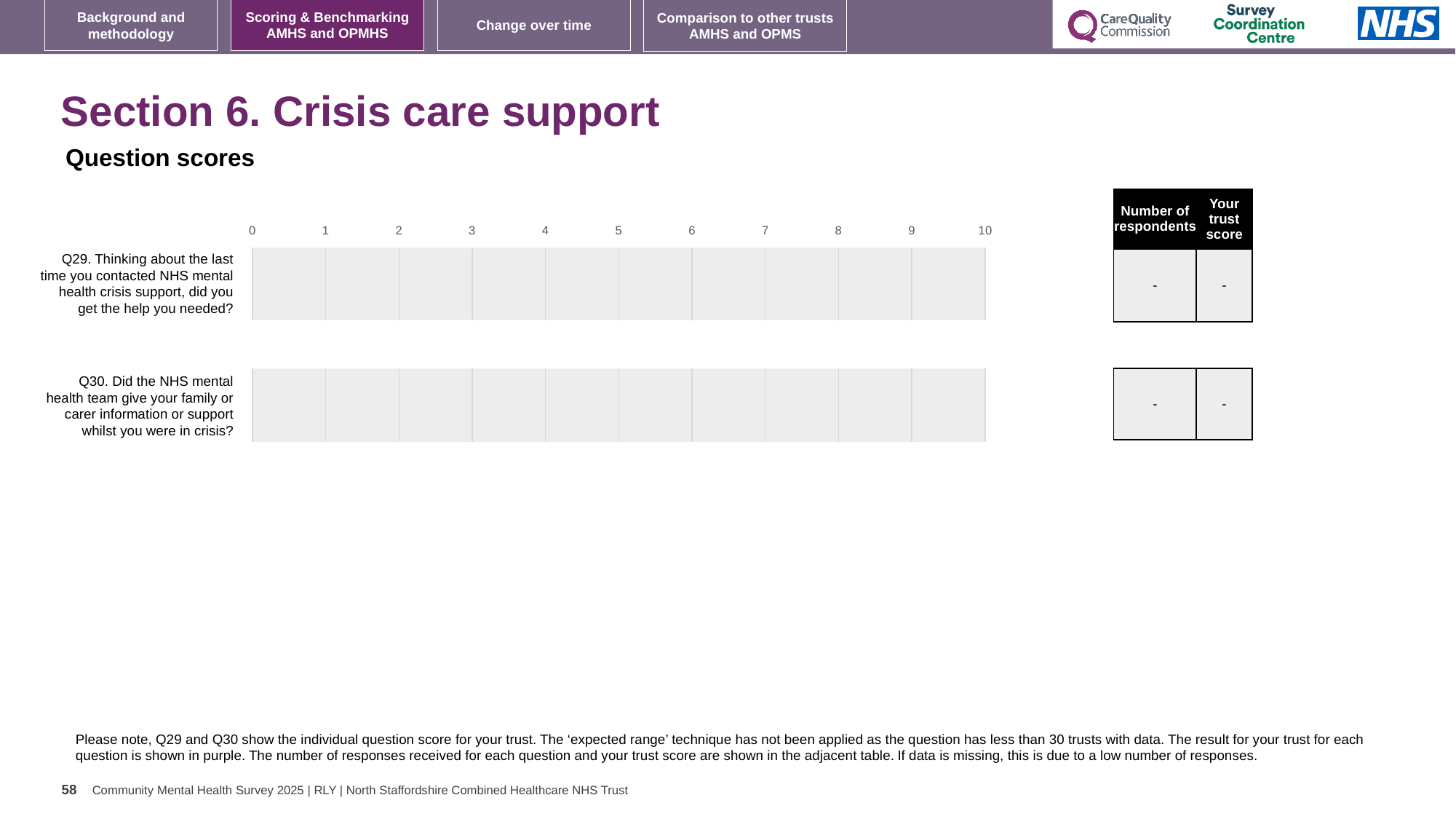
How many questions (categories) are shown on the chart? 2 What is the trust score shown in the table for Q30? - What is the lowest value shown on the chart's horizontal axis? 0 What is the trust score shown in the table for Q29? - What kind of chart is shown on the slide? bar chart What is the number of respondents shown in the table for Q29? - What is the highest value shown on the chart's horizontal axis? 10 What is the number of respondents shown in the table for Q30? -